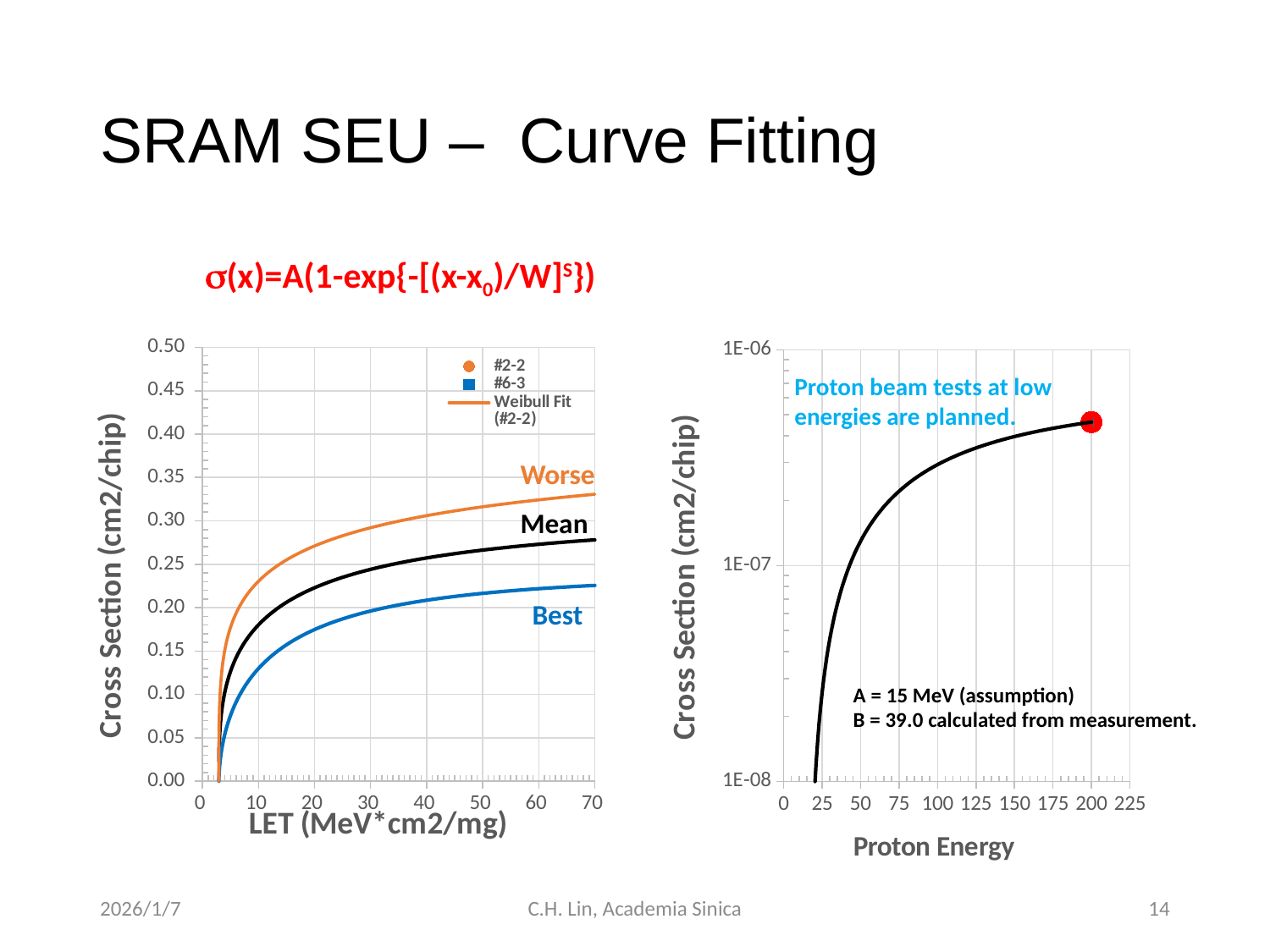
In the left chart, is the value of the Best curve at LET 70 greater or less than 0.25? less In the left chart, what is the x-axis title? LET (MeV*cm2/mg) In the left chart, how many entries does the legend list? 3 In the left chart, do the curves rise or fall as LET increases? rise In the left chart, which of the three labelled curves is the lowest? Best What kind of chart is the left chart (Cross Section vs LET)? line chart In the right chart, does the cross section rise or fall as proton energy increases? rise In the right chart, is the cross section at a proton energy of 200 greater or less than 1E-07? greater In the left chart, which curve is higher at LET 70, Worse or Best? Worse In the left chart, is the value of the Mean curve at LET 70 greater or less than 0.30? less In the right chart, what is the x-axis title? Proton Energy